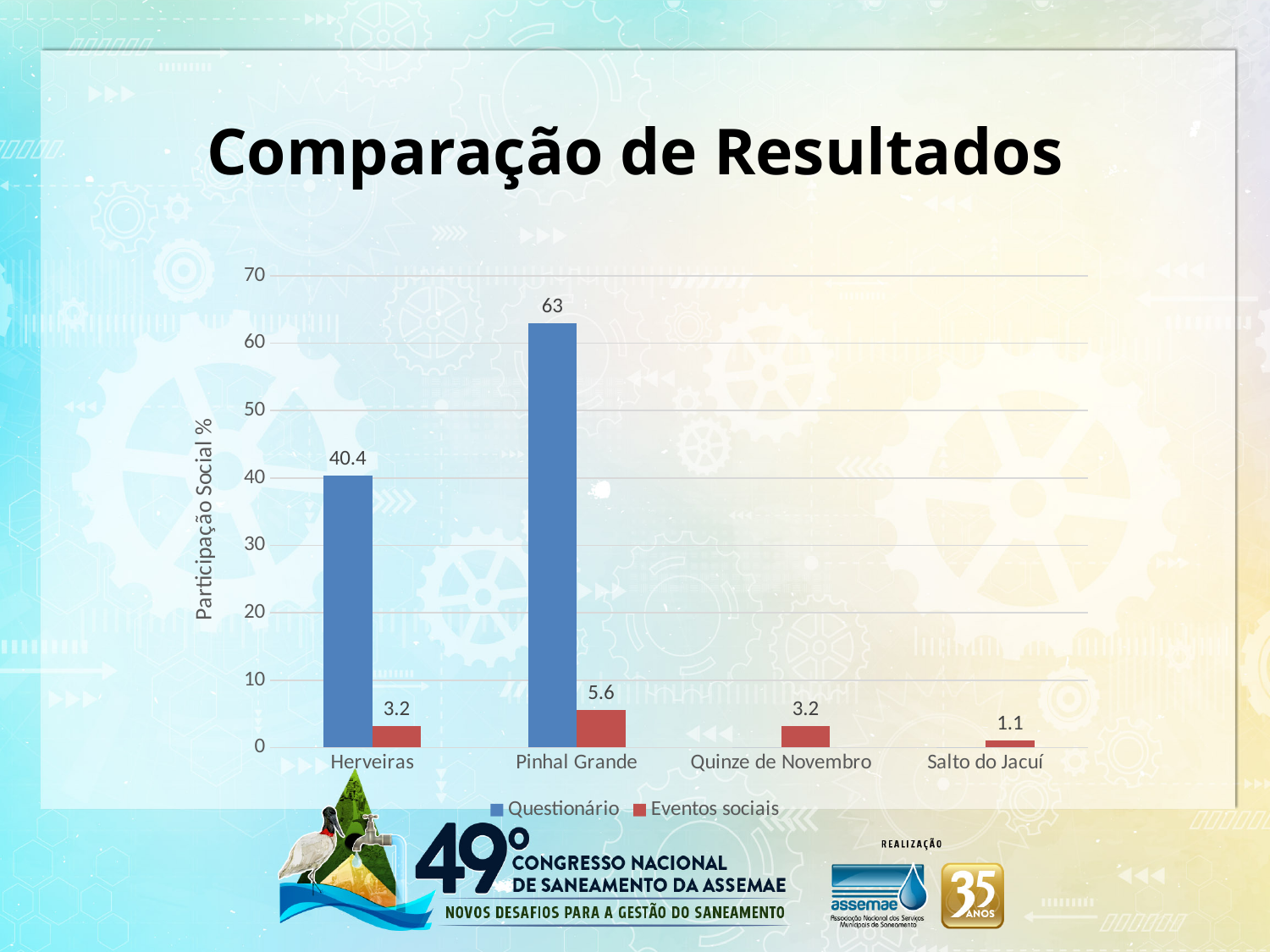
Which is larger: the Eventos sociais value for Herveiras or for Salto do Jacuí? Herveiras How many series does the legend list? 2 Which category has the lowest Eventos sociais value? Salto do Jacuí What is the difference between the Questionário values for Pinhal Grande and Herveiras? 22.6 What is the Eventos sociais value for Salto do Jacuí? 1.1 What is the title of the chart? Comparação de Resultados Is the Questionário value for Pinhal Grande greater or less than 60? greater Which category has the highest Eventos sociais value? Pinhal Grande How many categories are shown on the x axis? 4 What is the Eventos sociais value for Pinhal Grande? 5.6 What is the Questionário value for Herveiras? 40.4 What is the Questionário value for Pinhal Grande? 63